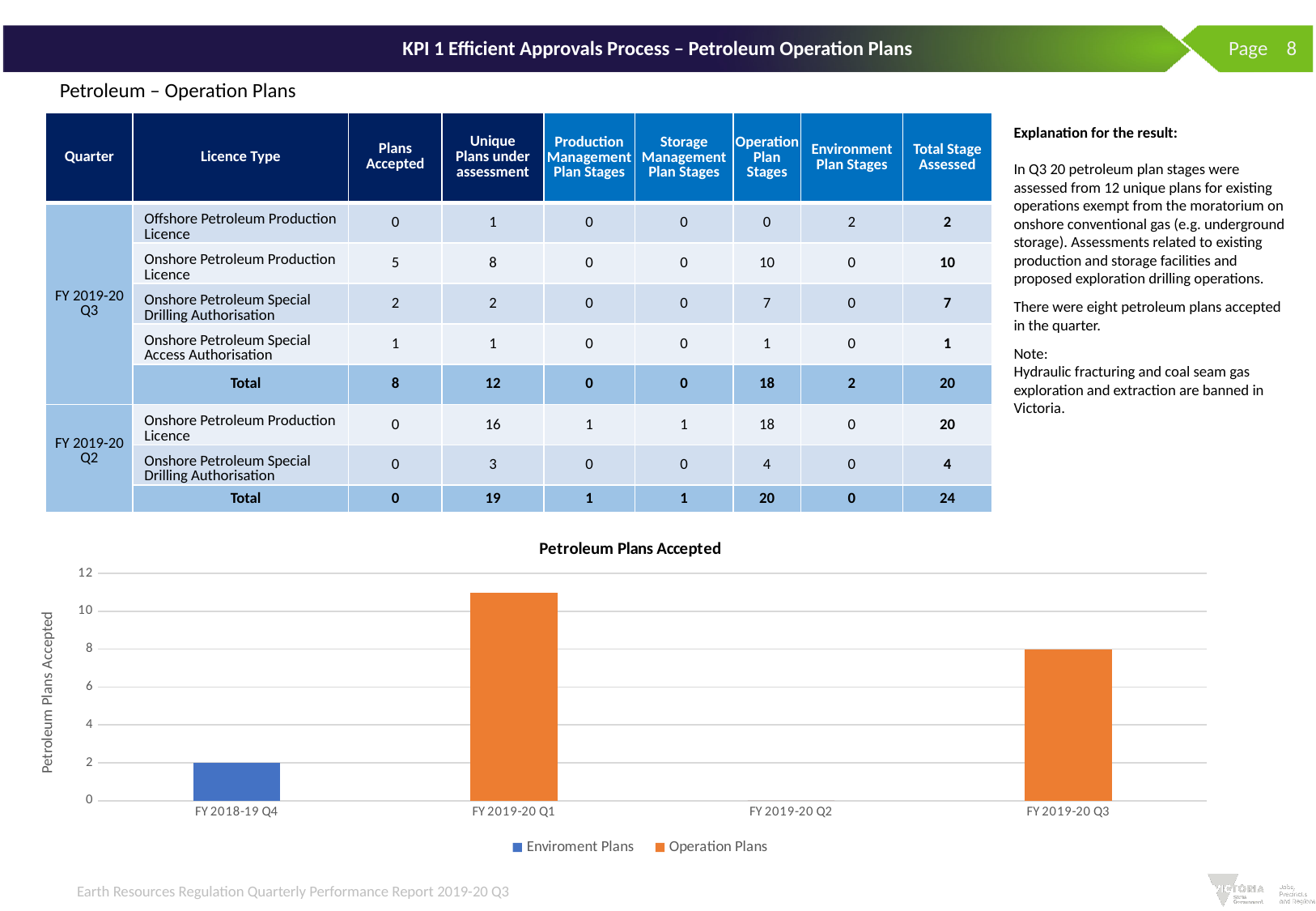
What colour represents Operation Plans in the "Petroleum Plans Accepted" chart? orange Which quarter has the lowest value in the "Petroleum Plans Accepted" chart? FY 2019-20 Q2 In the "Petroleum Plans Accepted" chart, is the value for FY 2019-20 Q1 greater or less than 10? greater How many series does the legend of the "Petroleum Plans Accepted" chart list? 2 What is the y-axis label of the "Petroleum Plans Accepted" chart? Petroleum Plans Accepted In the "Petroleum Plans Accepted" chart, what is the value of Operation Plans for FY 2019-20 Q3? 8 Which quarter has the highest bar in the "Petroleum Plans Accepted" chart? FY 2019-20 Q1 In the "Petroleum Plans Accepted" chart, what is the difference between the FY 2019-20 Q3 value and the FY 2018-19 Q4 value? 6 How many quarters are shown on the x axis of the "Petroleum Plans Accepted" chart? 4 In the "Petroleum Plans Accepted" chart, what is the value of Enviroment Plans for FY 2018-19 Q4? 2 What type of chart is the "Petroleum Plans Accepted" chart? bar chart In the "Petroleum Plans Accepted" chart, which is larger: the bar for FY 2019-20 Q1 or the bar for FY 2019-20 Q3? FY 2019-20 Q1